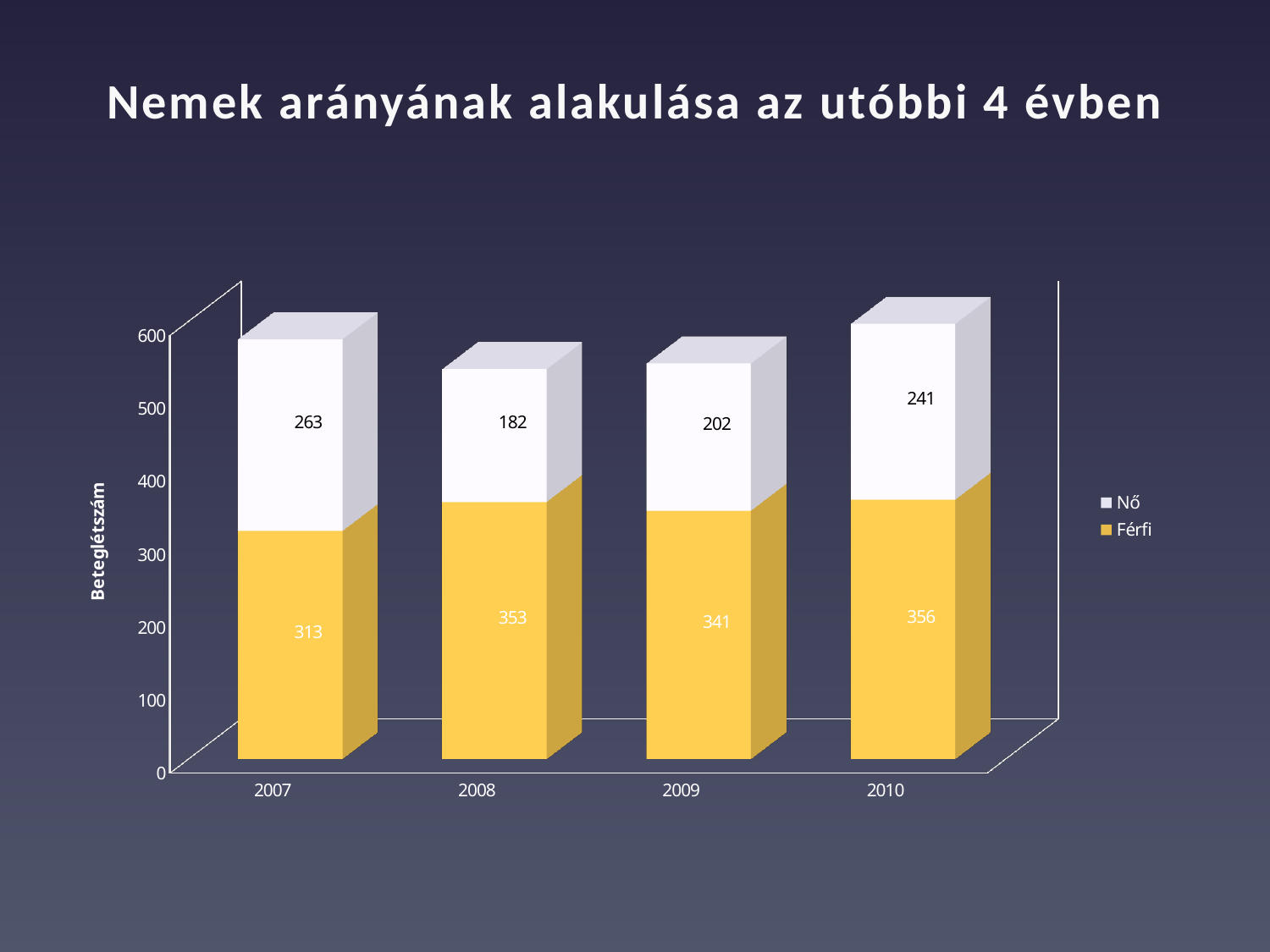
In which year is the Nő value the lowest? 2008 What is the total of the stacked bar for 2008? 535 What is the difference between the Férfi and Nő values in 2009? 139 What is the total of the stacked bar for 2010? 597 What is the value for Nő in 2007? 263 How many series does the legend list? 2 What is the value for Férfi in 2008? 353 What is the value for Nő in 2010? 241 In which year is the Férfi value the highest? 2010 What kind of chart is shown on the slide? Stacked bar chart How many years are shown on the x axis? 4 Which is larger in 2007: the Férfi value or the Nő value? Férfi